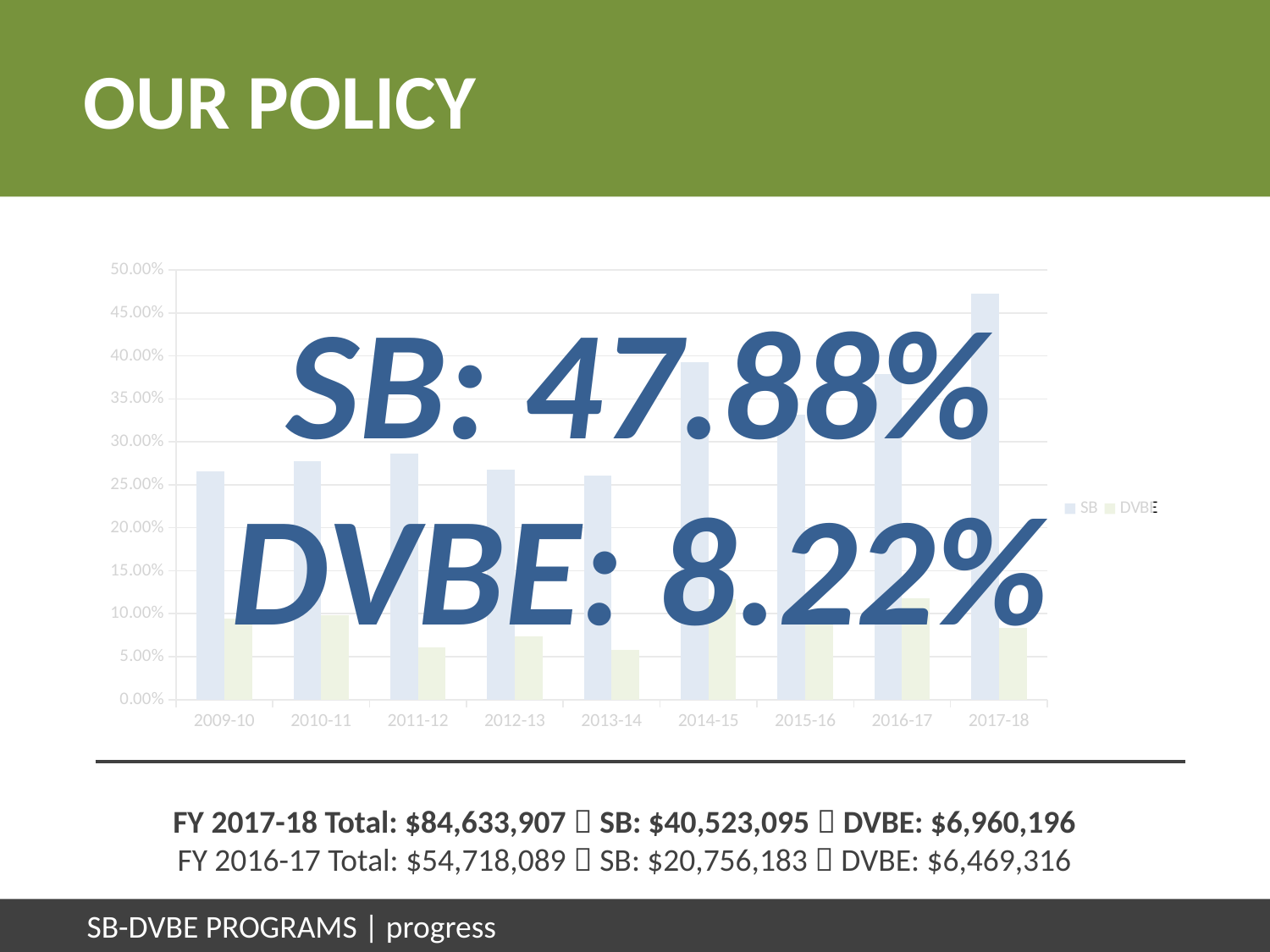
Is the SB value for 2009-10 greater or less than 30.00%? less How many series does the chart legend list? 2 Is the SB value for 2014-15 greater or less than 35.00%? greater Which two series are listed in the chart legend? SB and DVBE According to the slide, what is the SB percentage for FY 2017-18? 47.88% Which fiscal year has the larger DVBE value, 2013-14 or 2014-15? 2014-15 Which fiscal year has the larger SB value, 2016-17 or 2017-18? 2017-18 In which fiscal year is the SB bar the highest? 2017-18 What kind of chart is shown on the slide? bar chart According to the slide, what is the DVBE percentage for FY 2017-18? 8.22% How many fiscal years are shown along the x axis of the chart? 9